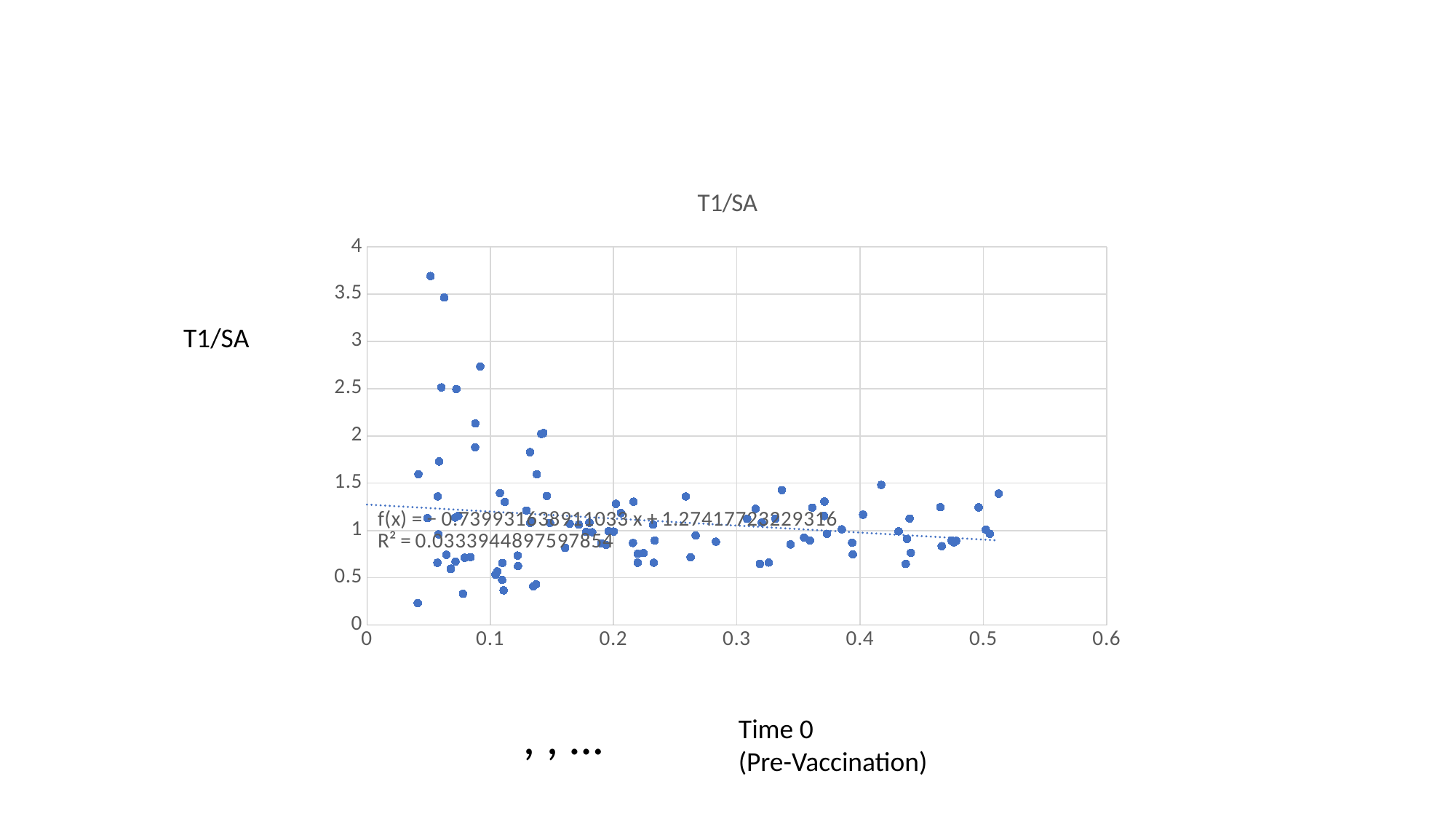
Is the highest plotted point greater or less than 3.5 on the y axis? greater What is the label on the x axis of the chart? Time 0 (Pre-Vaccination) What is the title of the chart? T1/SA What kind of chart is shown on the slide? scatter chart Are the points with x values above 0.3 mostly above or below 2 on the y axis? below Is the R² value shown on the chart greater or less than 0.1? less Does the dotted trendline rise or fall as the x value increases? fall Is the slope of the fitted line f(x) positive or negative? negative